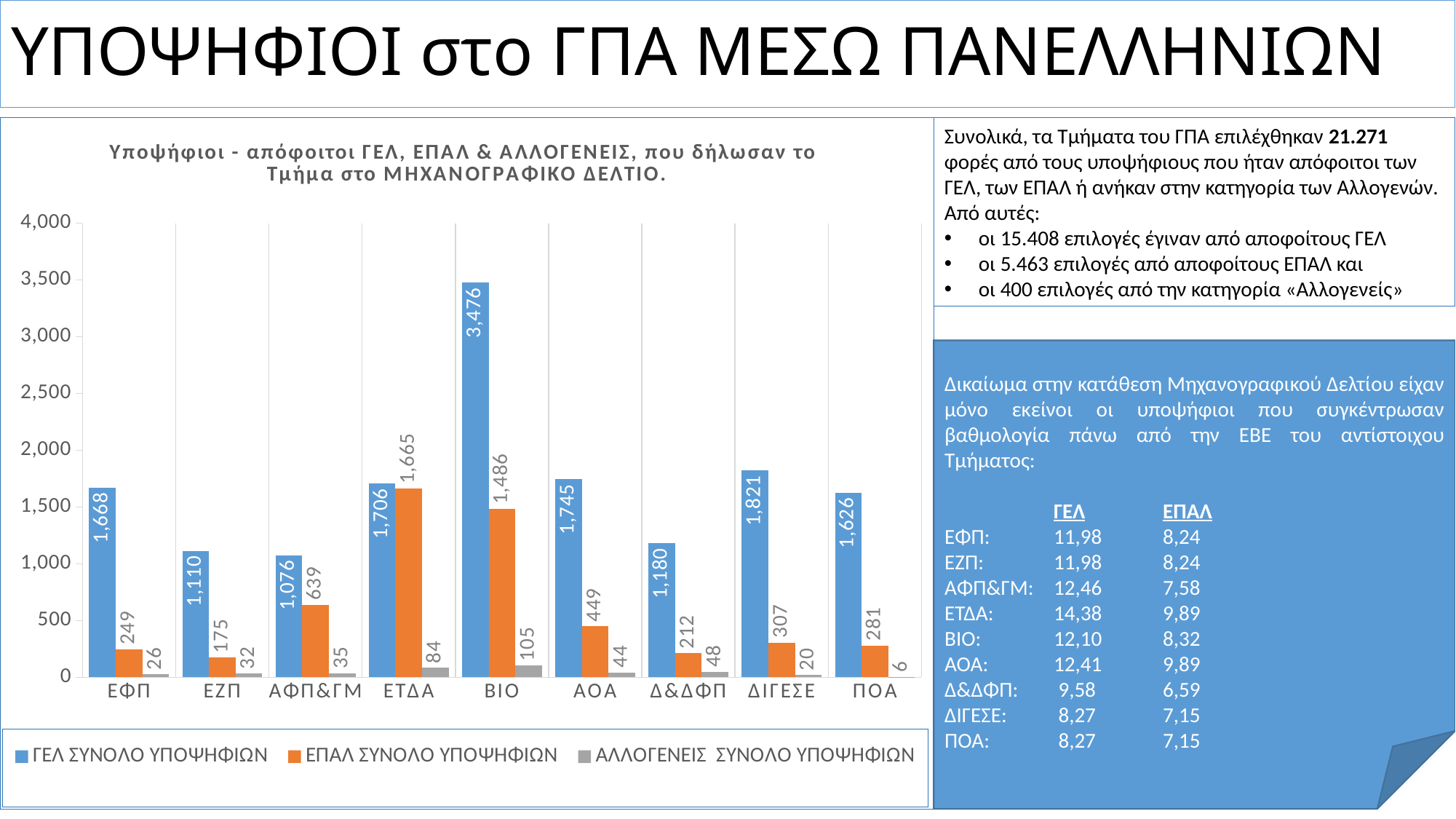
Which category has the lowest ΕΠΑΛ ΣΥΝΟΛΟ ΥΠΟΨΗΦΙΩΝ value? ΕΖΠ What kind of chart is shown on the slide? Bar chart What is the ΓΕΛ ΣΥΝΟΛΟ ΥΠΟΨΗΦΙΩΝ value for ΒΙΟ? 3,476 What is the ΑΛΛΟΓΕΝΕΙΣ ΣΥΝΟΛΟ ΥΠΟΨΗΦΙΩΝ value for ΠΟΑ? 6 Which is larger: the ΕΠΑΛ value for ΑΦΠ&ΓΜ or the ΕΠΑΛ value for ΑΟΑ? ΑΦΠ&ΓΜ What is the difference between the ΓΕΛ values for ΔΙΓΕΣΕ and ΕΦΠ? 153 Which colour represents ΕΠΑΛ ΣΥΝΟΛΟ ΥΠΟΨΗΦΙΩΝ in the chart? Orange Which category has the highest ΓΕΛ ΣΥΝΟΛΟ ΥΠΟΨΗΦΙΩΝ value? ΒΙΟ What is the ΕΠΑΛ ΣΥΝΟΛΟ ΥΠΟΨΗΦΙΩΝ value for ΕΤΔΑ? 1,665 How many categories are shown on the x axis of the chart? 9 How many series does the chart legend list? 3 Is the ΓΕΛ value for ΑΟΑ greater or less than 1,500? greater